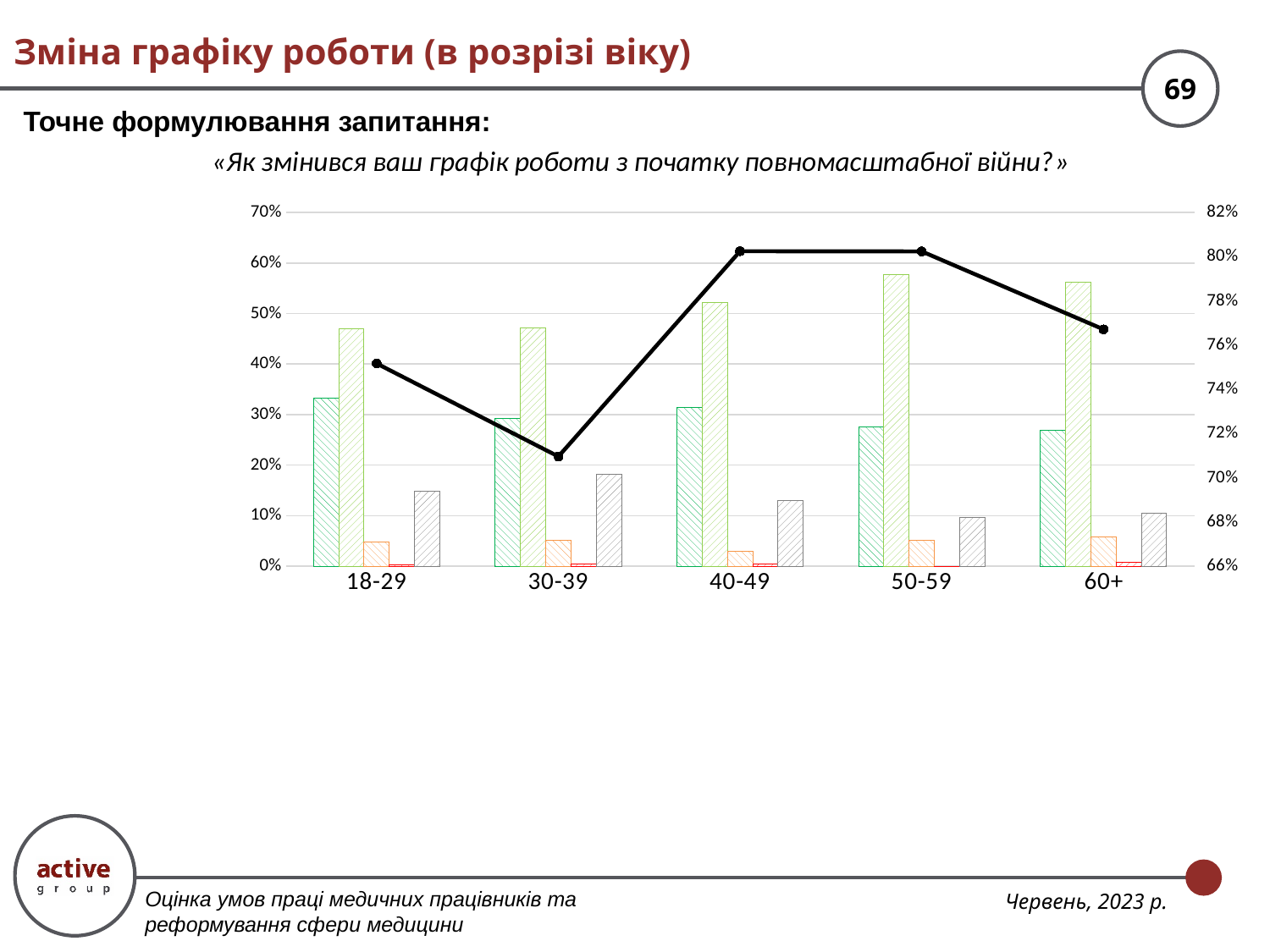
What kind of chart is shown on the slide? A combined bar and line chart Is the value of the black line for the 40-49 age group greater or less than 78%? greater Does the black line rise or fall from the 30-39 group to the 40-49 group? rise Is the second (light green) bar in the 50-59 group greater or less than 50%? greater Is the value of the black line for the 30-39 age group greater or less than 74%? less Which age group has the lowest value on the black line? 30-39 Does the black line rise or fall from the 50-59 group to the 60+ group? fall How many age groups are shown on the x axis of the chart? 5 What is the title of the chart slide? Зміна графіку роботи (в розрізі віку) Which is larger for the black line: the value for 18-29 or the value for 30-39? 18-29